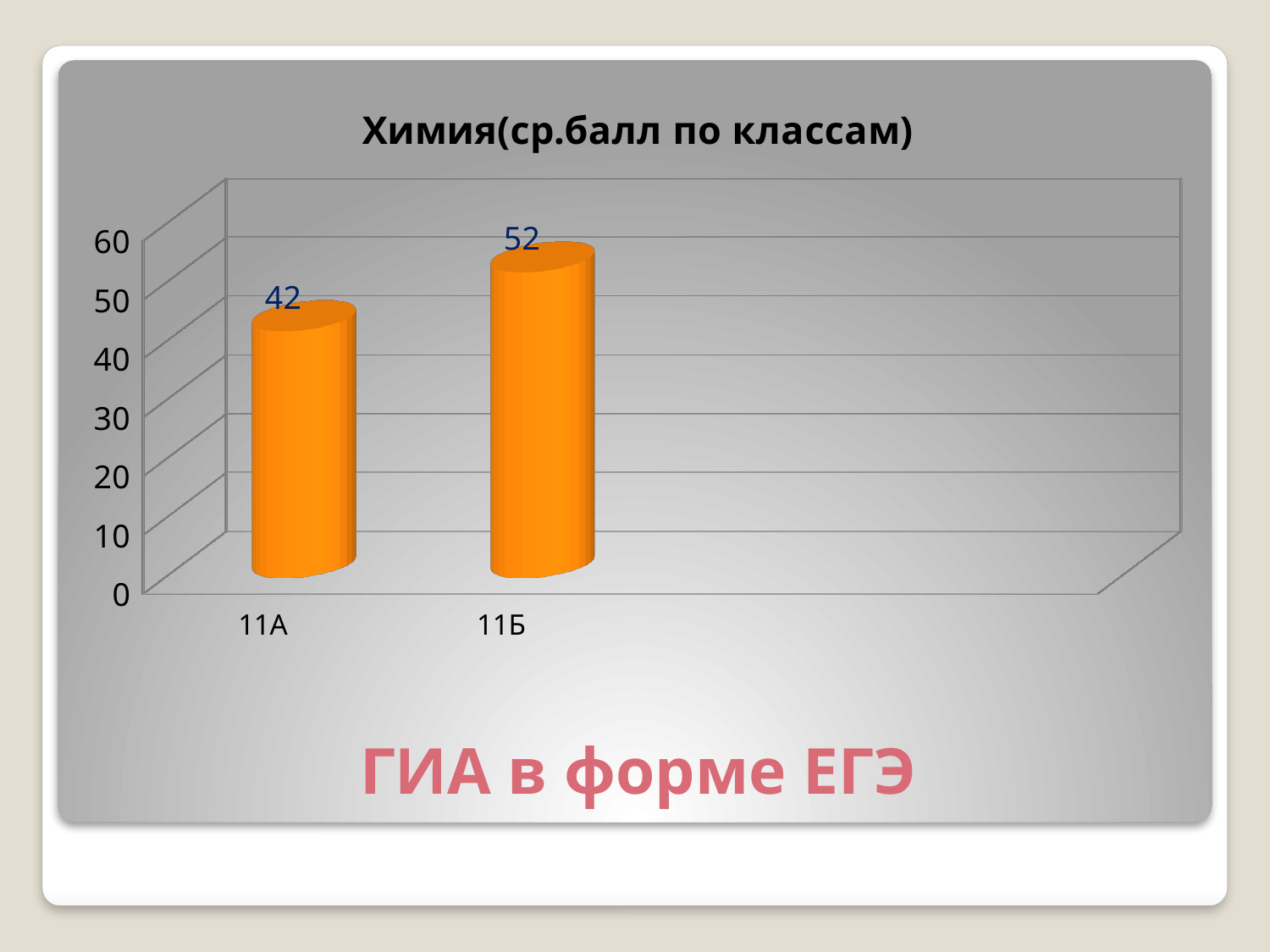
Which class has the highest value? 11Б Is the value for 11А greater or less than 50? less Is the value for 11Б greater or less than 50? greater What is the difference between the values for 11Б and 11А? 10 What is the title of the chart? Химия(ср.балл по классам) What kind of chart is shown on the slide? bar chart What colour are the bars on the chart? orange What is the value for 11Б? 52 Which is larger, the value for 11А or the value for 11Б? 11Б Which class has the lowest value? 11А How many classes are shown on the chart? 2 What is the value for 11А? 42